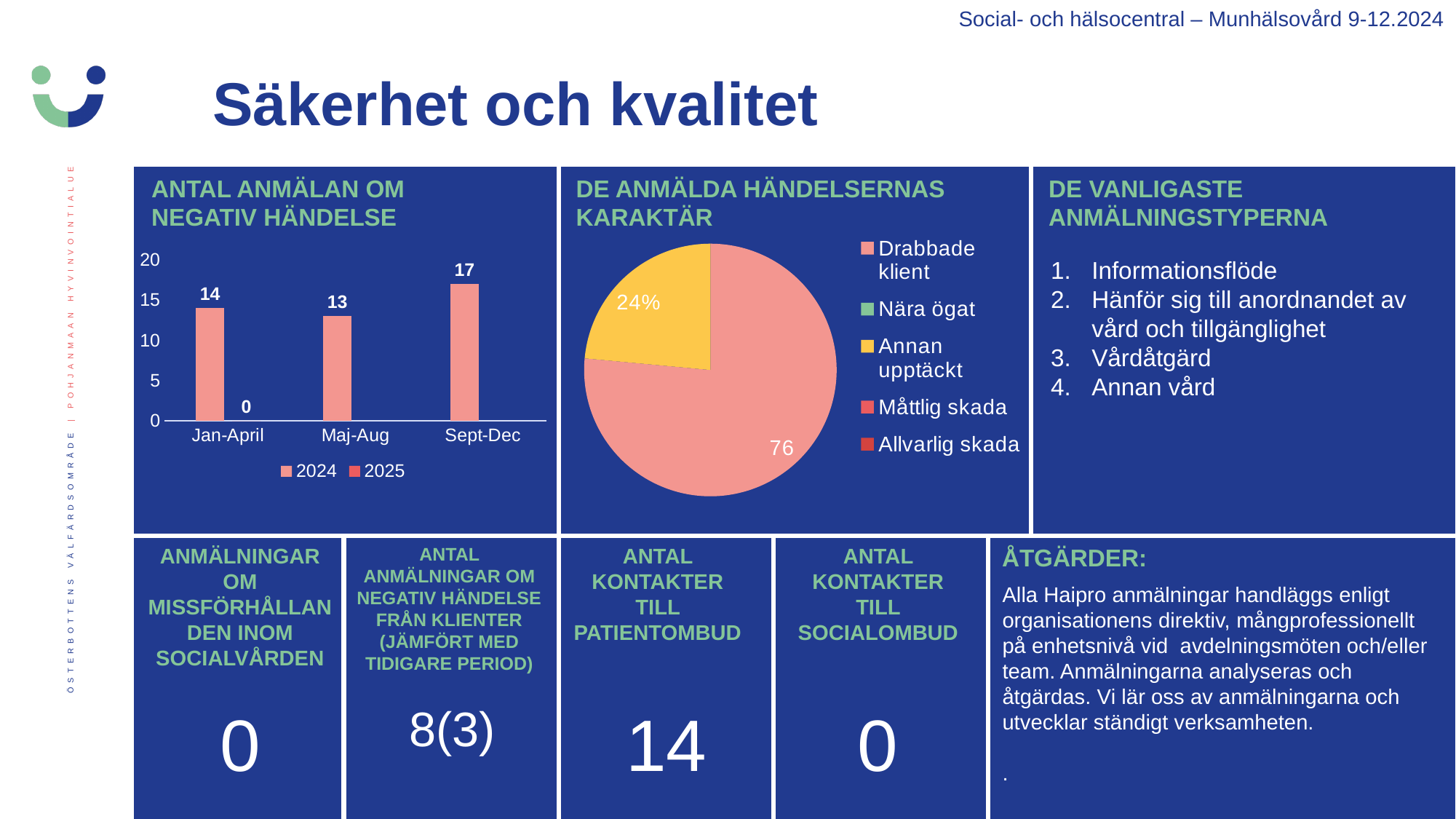
In the chart 'ANTAL ANMÄLAN OM NEGATIV HÄNDELSE', how many periods are shown on the x axis? 3 In the chart 'ANTAL ANMÄLAN OM NEGATIV HÄNDELSE', how many series does the legend list? 2 In the chart 'ANTAL ANMÄLAN OM NEGATIV HÄNDELSE', which period has the highest 2024 value? Sept-Dec In the chart 'ANTAL ANMÄLAN OM NEGATIV HÄNDELSE', what is the 2024 value for Maj-Aug? 13 In the chart 'ANTAL ANMÄLAN OM NEGATIV HÄNDELSE', which period has the lowest 2024 value? Maj-Aug In the chart 'ANTAL ANMÄLAN OM NEGATIV HÄNDELSE', is the 2024 value for Jan-April greater or less than 10? greater In the chart 'ANTAL ANMÄLAN OM NEGATIV HÄNDELSE', what is the difference between the 2024 values for Sept-Dec and Jan-April? 3 In the chart 'ANTAL ANMÄLAN OM NEGATIV HÄNDELSE', what is the 2025 value for Jan-April? 0 What kind of chart is 'DE ANMÄLDA HÄNDELSERNAS KARAKTÄR'? pie chart In the chart 'DE ANMÄLDA HÄNDELSERNAS KARAKTÄR', how many entries does the legend list? 5 In the chart 'ANTAL ANMÄLAN OM NEGATIV HÄNDELSE', what is the 2024 value for Sept-Dec? 17 What kind of chart is 'ANTAL ANMÄLAN OM NEGATIV HÄNDELSE'? bar chart